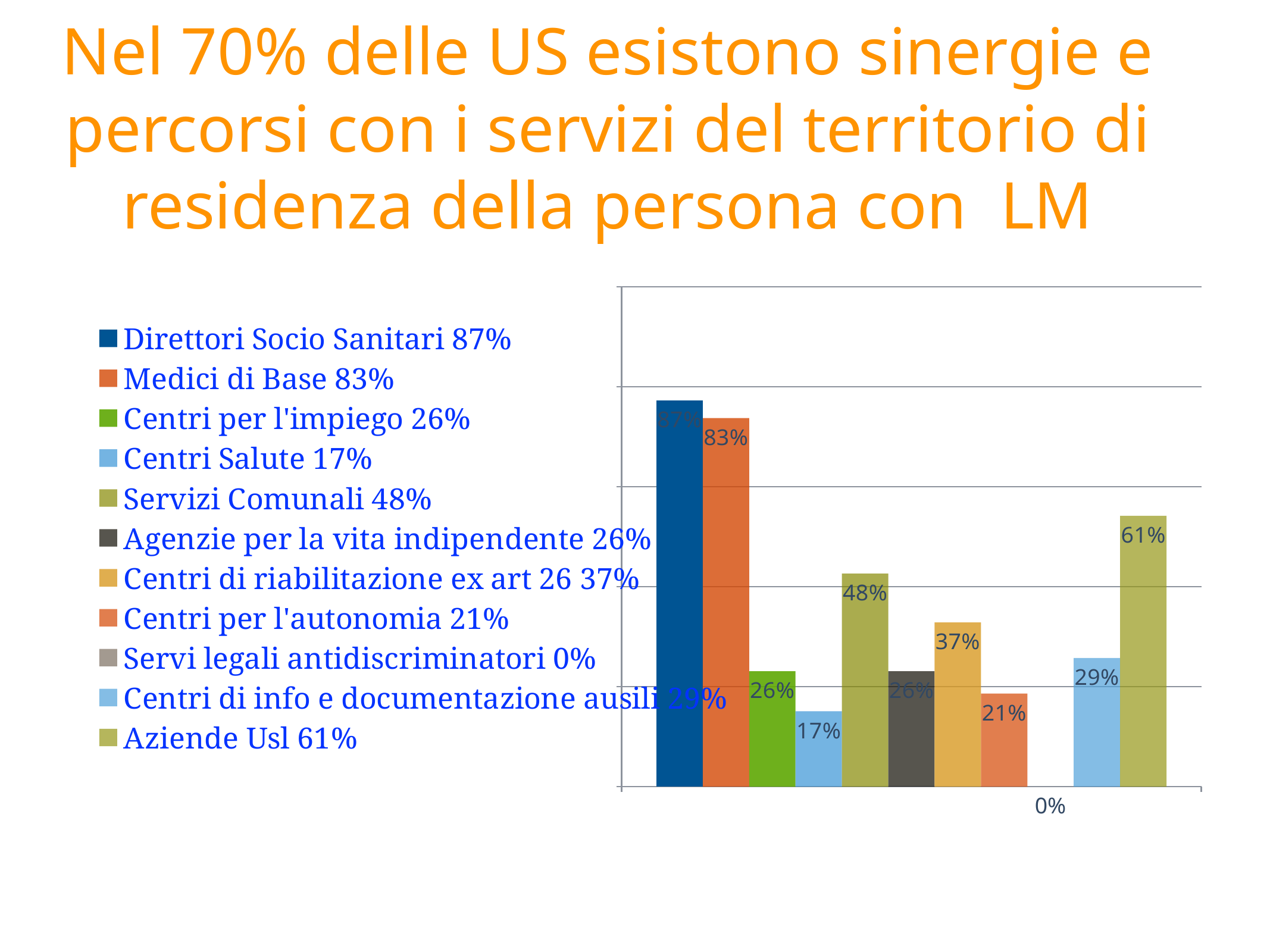
What colour is the bar for Direttori Socio Sanitari? dark blue What kind of chart is shown on the slide? bar chart What is the difference between the values for Aziende Usl and Centri per l'autonomia? 40% Which series has the lowest value? Servi legali antidiscriminatori What is the value for Centri di riabilitazione ex art 26? 37% Which is larger, the value for Servizi Comunali or the value for Centri di info e documentazione ausili? Servizi Comunali How many series does the legend list? 11 What is the value for Direttori Socio Sanitari? 87% Which series has the highest value? Direttori Socio Sanitari What is the value for Aziende Usl? 61% What is the value for Servi legali antidiscriminatori? 0% What is the difference between the values for Medici di Base and Centri Salute? 66%